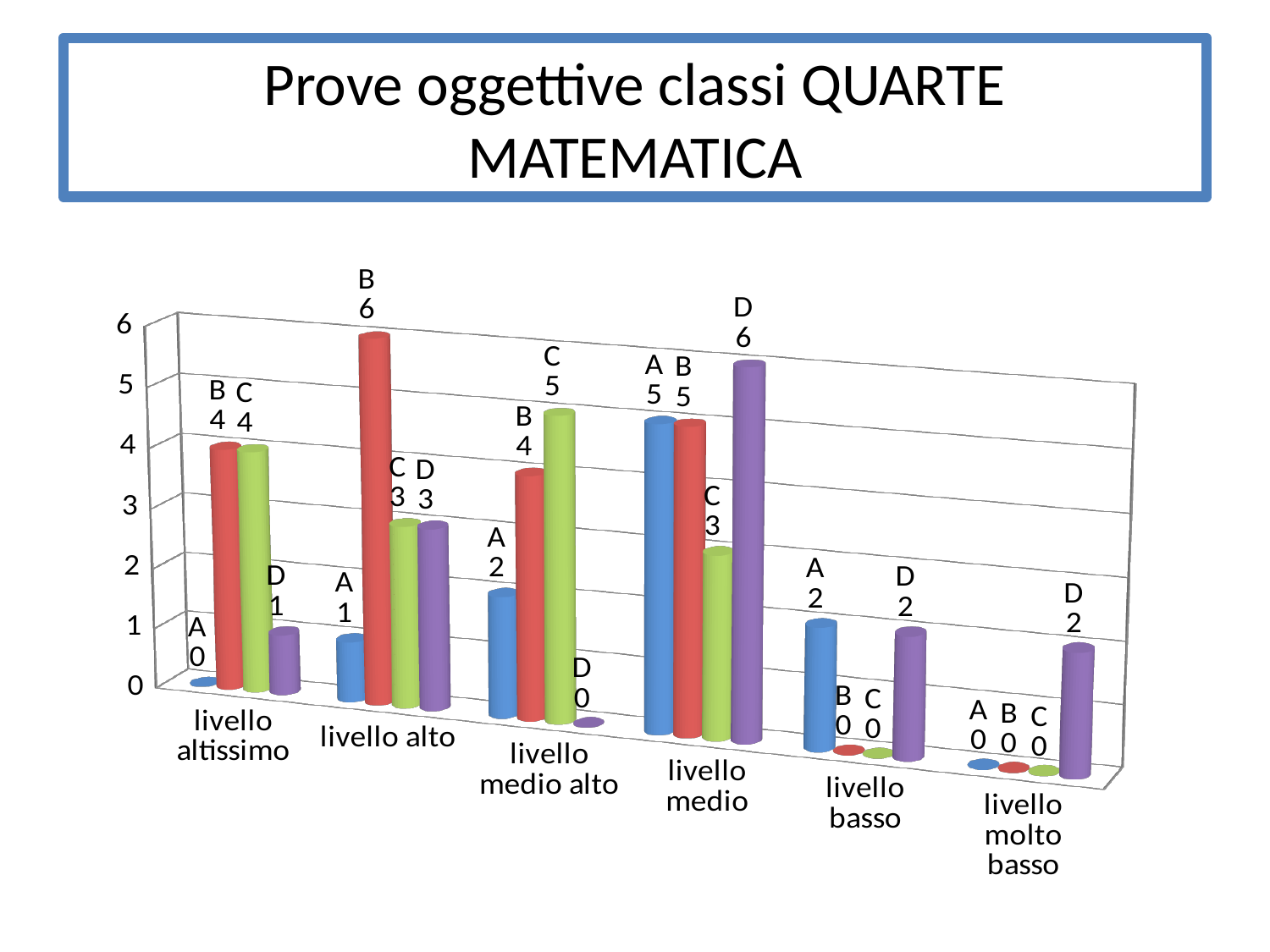
How many categories are shown on the x axis? 6 What is the value for series B in the 'livello alto' category? 6 Which series has the highest value in the 'livello medio' category? D Which series has the lowest value in the 'livello alto' category? A What is the value for series C in the 'livello medio alto' category? 5 What is the value for series A in the 'livello altissimo' category? 0 What is the total of the values for series A, B, C and D in the 'livello basso' category? 4 What is the title of the slide containing the chart? Prove oggettive classi QUARTE MATEMATICA What kind of chart is shown on the slide? bar chart What is the value for series D in the 'livello medio' category? 6 Which is larger in the 'livello medio alto' category: the value for series B or series C? C What is the difference between the values for series B and series A in the 'livello alto' category? 5